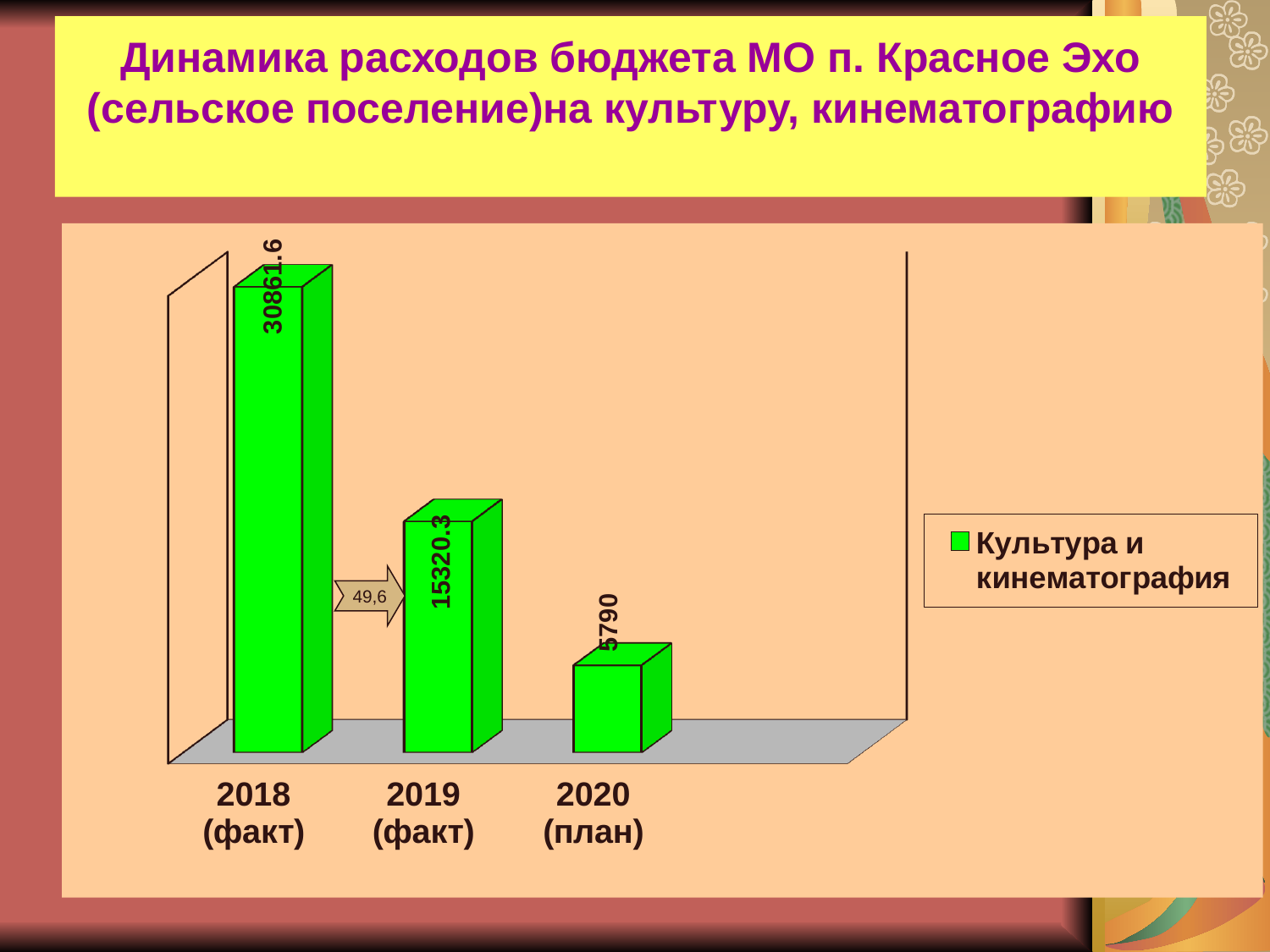
What kind of chart is shown on the slide? bar chart How many series does the legend list? 1 Which year has the lowest value? 2020 (план) What is the difference between the values for 2019 (факт) and 2020 (план)? 9530.3 What is the value for 2018 (факт)? 30861.6 What is the value for 2019 (факт)? 15320.3 Which year has the highest value? 2018 (факт) How many categories are shown on the x axis? 3 What is the value for 2020 (план)? 5790 Do the values rise or fall from 2018 to 2020? fall Which is larger, the value for 2019 (факт) or the value for 2020 (план)? 2019 (факт) What is the difference between the values for 2018 (факт) and 2019 (факт)? 15541.3